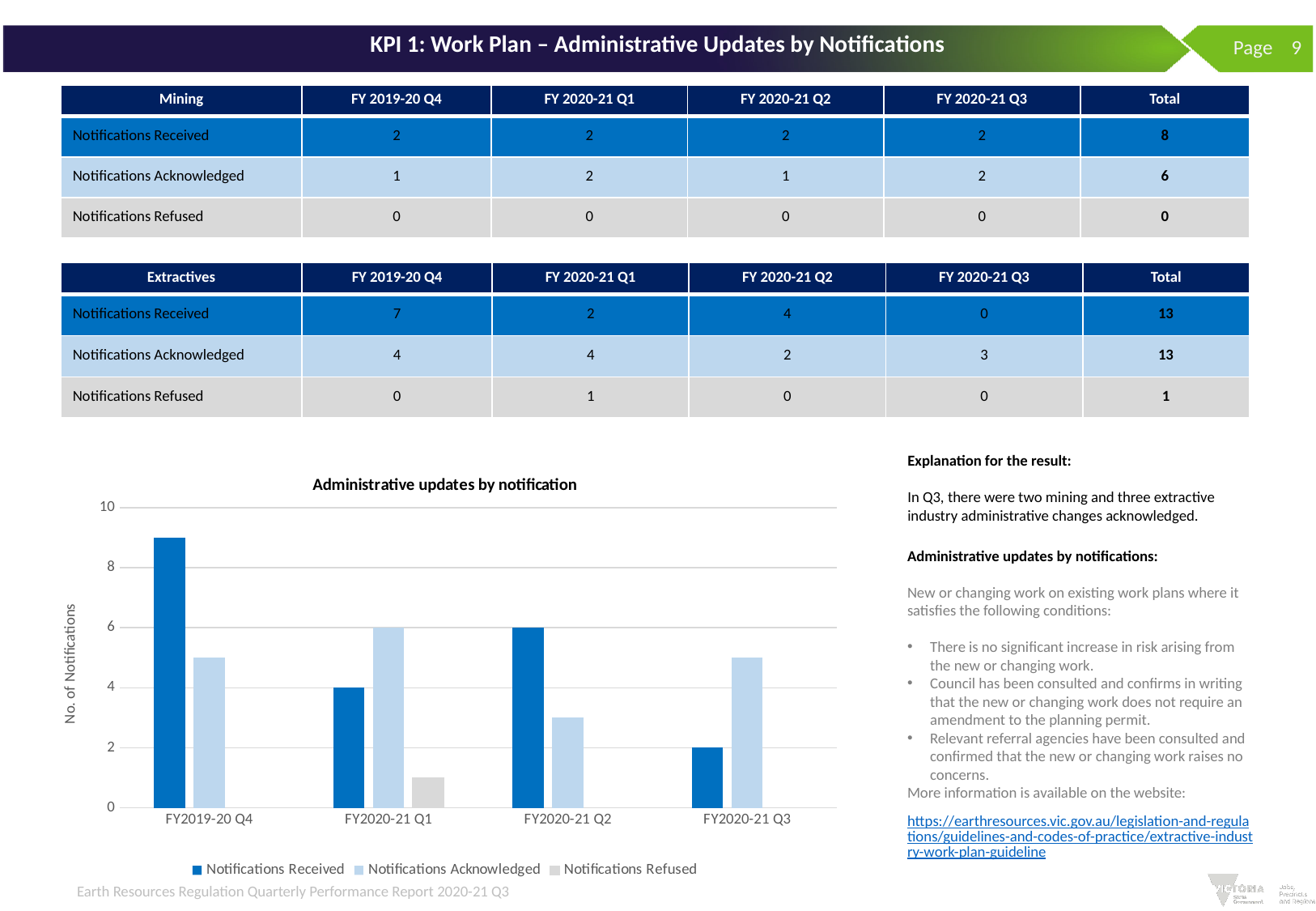
What is the value of Notifications Acknowledged for FY2020-21 Q1? 6 What is the difference between Notifications Received in FY2020-21 Q2 and FY2020-21 Q3? 4 In which quarter is Notifications Acknowledged lowest? FY2020-21 Q2 How many quarters are shown on the x axis of the chart? 4 What is the value of Notifications Received for FY2020-21 Q3? 2 In which quarter is Notifications Received highest? FY2019-20 Q4 What is the value of Notifications Received for FY2020-21 Q2? 6 How many series does the chart legend list? 3 What type of chart is shown on the slide? bar chart Is the value of Notifications Received for FY2019-20 Q4 greater or less than 8? greater In FY2020-21 Q1, which is larger: Notifications Received or Notifications Acknowledged? Notifications Acknowledged What is the title of the y axis on the chart? No. of Notifications